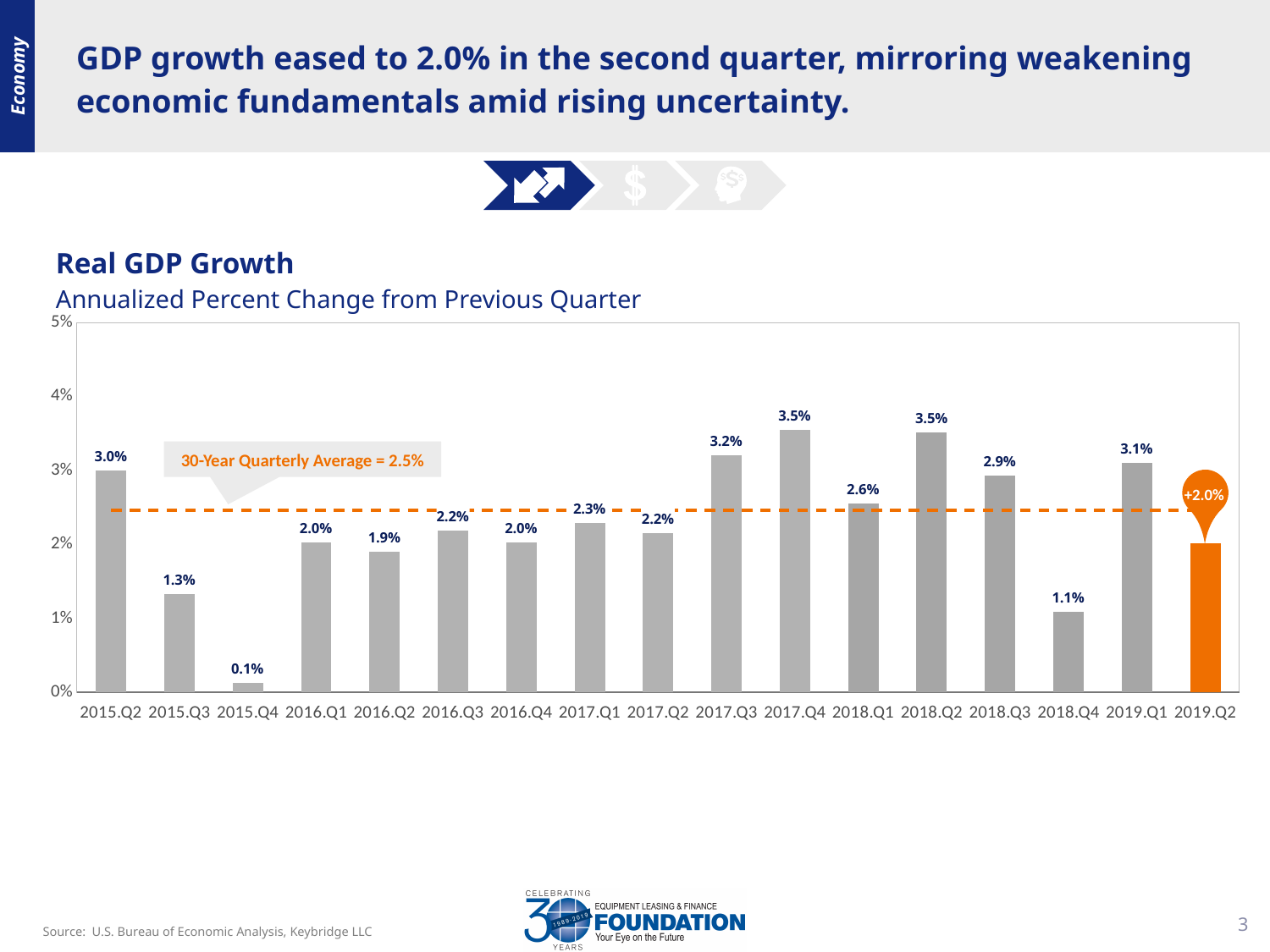
Which quarter has the lowest value? 2015.Q4 What is the value for 2018.Q3? 2.9% Which is larger, the value for 2017.Q3 or the value for 2018.Q4? 2017.Q3 What is the subtitle of the chart below 'Real GDP Growth'? Annualized Percent Change from Previous Quarter What is the difference between the values for 2017.Q4 and 2018.Q1? 0.9% What kind of chart is this? bar chart What is the value for 2019.Q2? +2.0% Is the value for 2015.Q2 greater or less than 2%? greater What is the value for 2015.Q4? 0.1% What is the difference between the values for 2019.Q1 and 2019.Q2? 1.1% How many quarters are shown on the x axis? 17 What is the 30-Year Quarterly Average shown by the dashed line? 2.5%